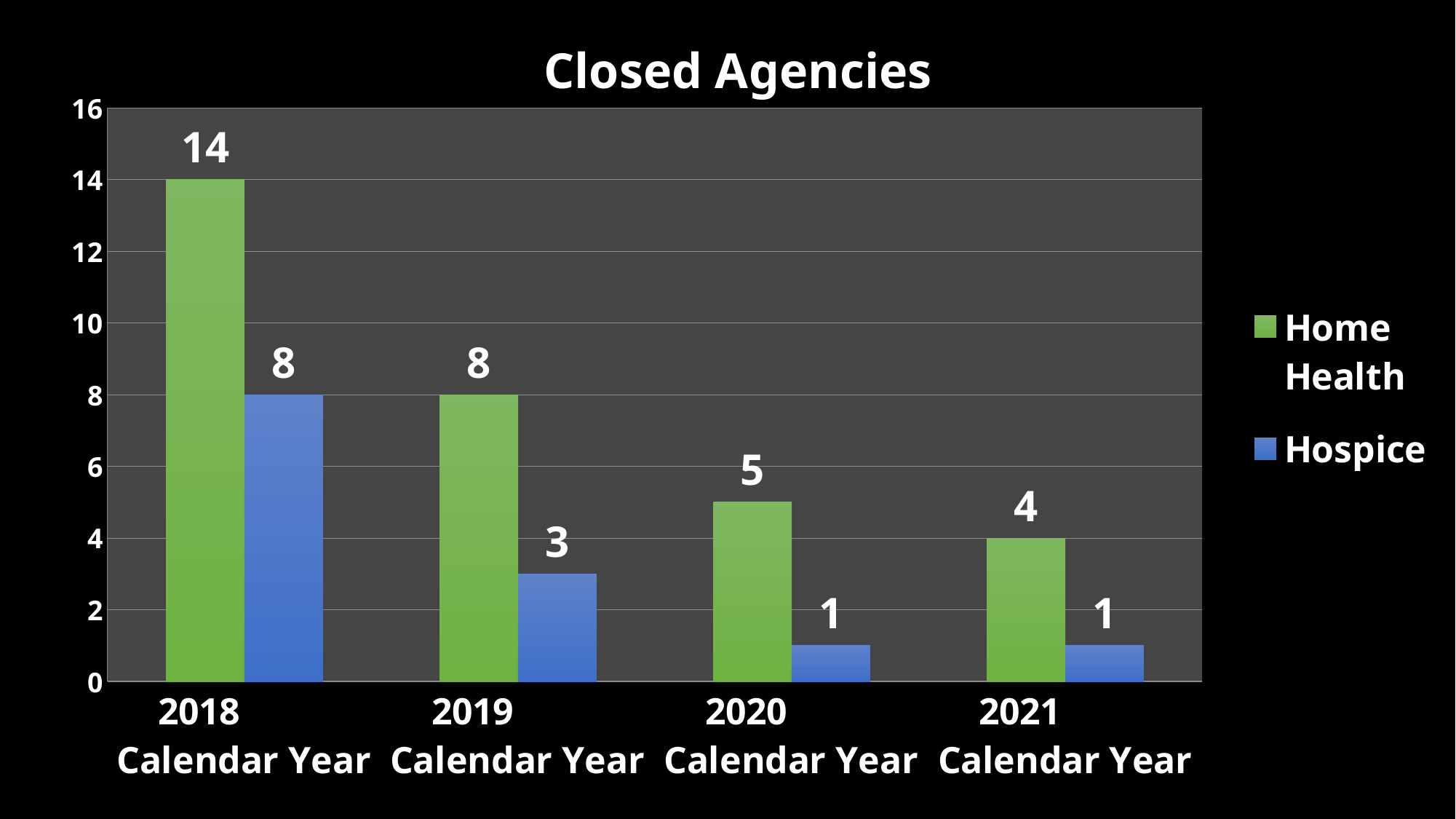
Do the Hospice values rise or fall from 2018 to 2020? Fall Which calendar year has the lowest Home Health value? 2021 Calendar Year What is the value for Home Health in 2021 Calendar Year? 4 What is the value for Home Health in 2018 Calendar Year? 14 What kind of chart is shown? Bar chart How many series does the legend list? 2 What is the difference between the Home Health and Hospice values in 2018 Calendar Year? 6 What is the value for Hospice in 2019 Calendar Year? 3 What is the title of the chart? Closed Agencies Which calendar year has the highest Home Health value? 2018 Calendar Year Which is larger in 2020 Calendar Year, Home Health or Hospice? Home Health How many calendar years are shown on the x axis? 4